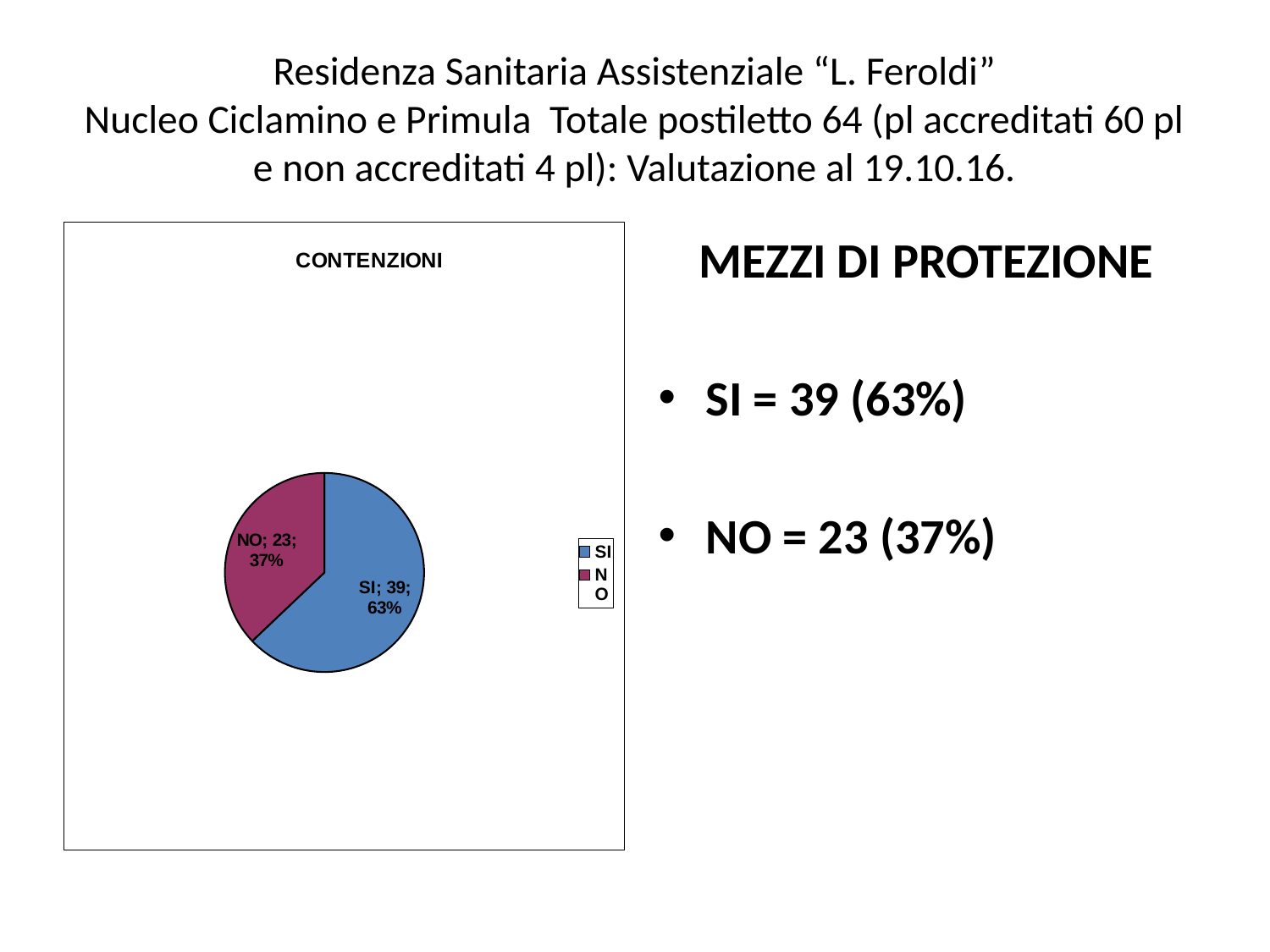
What share of the pie does the SI slice represent? 63% What is the value for SI in the pie chart? 39 What kind of chart is shown on the slide? pie chart Which is larger, the value for SI or the value for NO? SI How many slices does the pie chart have? 2 What share of the pie does the NO slice represent? 37% What is the difference between the SI and NO values? 16 What is the title of the chart? CONTENZIONI What is the value for NO in the pie chart? 23 Which slice of the pie chart is the smallest? NO Which slice of the pie chart is the largest? SI What is the total of the SI and NO values in the pie chart? 62